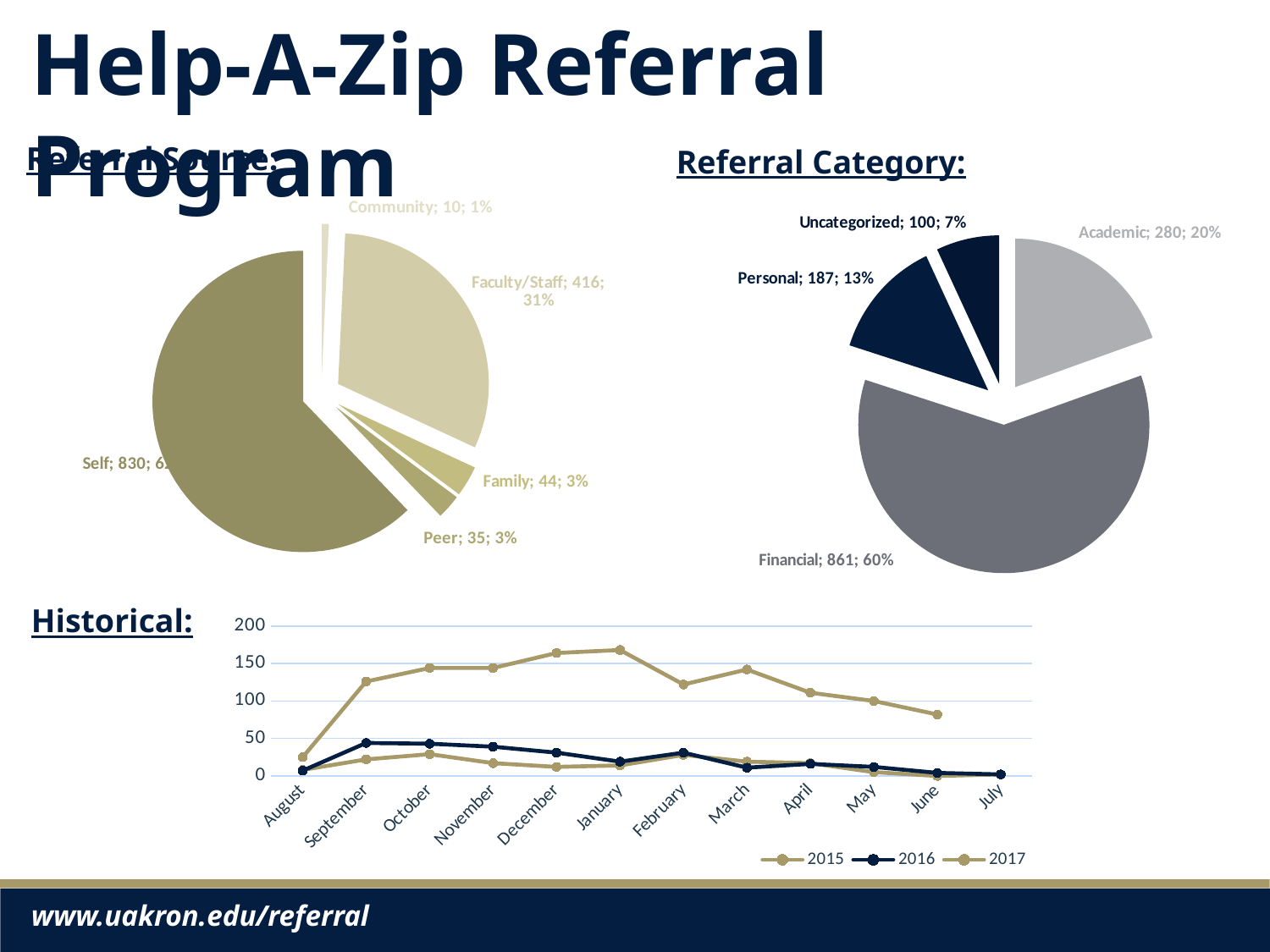
In the left pie chart (referral sources), what share of referrals came from Community? 1% In the left pie chart (referral sources), which source has the largest slice? Self In the left pie chart (referral sources), how many referrals came from Faculty/Staff? 416 In the Referral Category pie chart, how many referrals were Financial? 861 What kind of chart is the Historical chart? Line chart In the Historical line chart, how many series does the legend list? 3 In the Referral Category pie chart, what is the difference between the Personal and Uncategorized counts? 87 In the Referral Category pie chart, how many categories are shown? 4 In the Historical line chart, is the 2017 value for January greater or less than 150? greater In the Referral Category pie chart, what share of referrals was Academic? 20% In the left pie chart (referral sources), which is larger, Family or Peer? Family In the Referral Category pie chart, which category has the smallest slice? Uncategorized